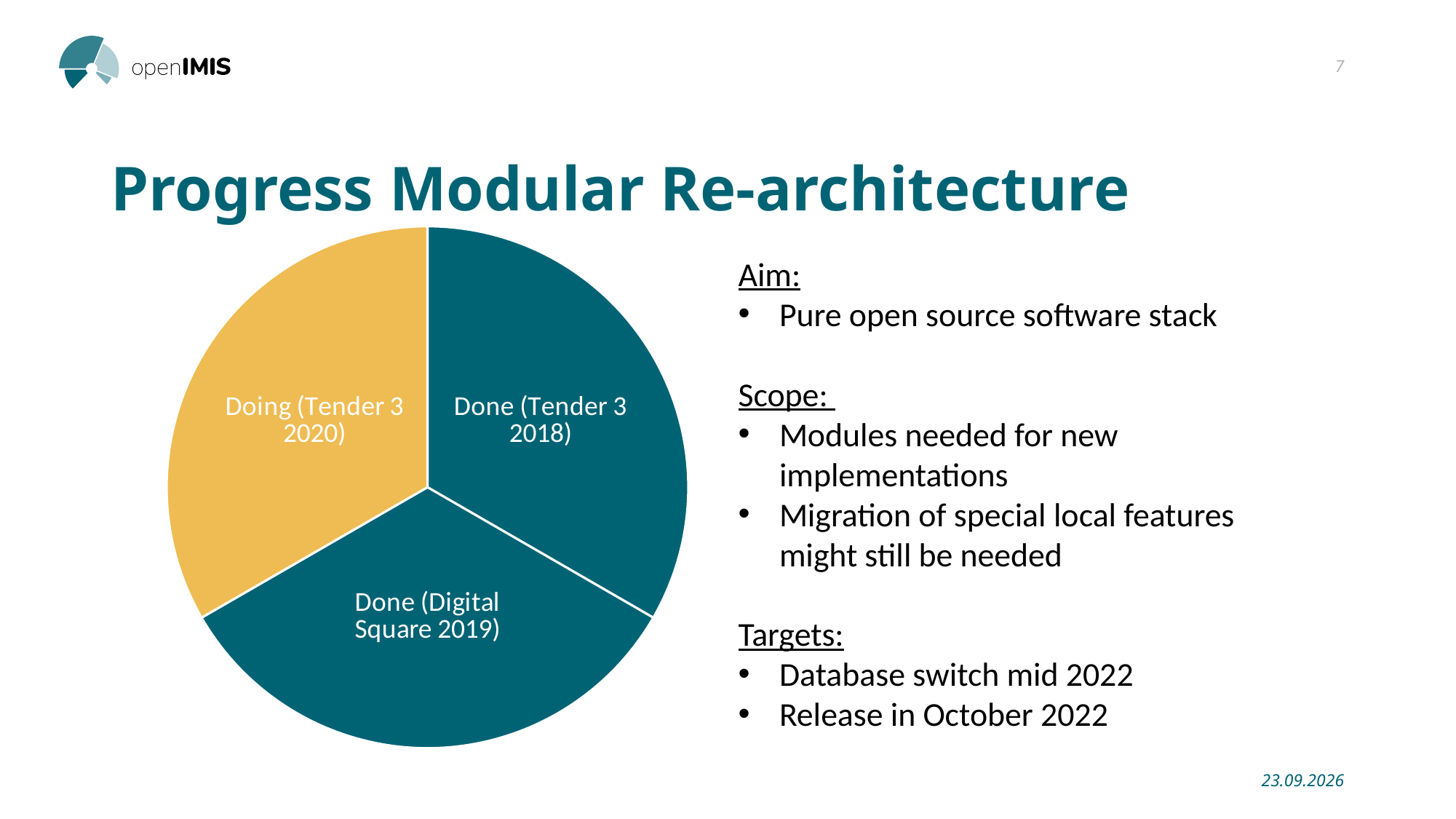
What kind of chart is shown on the slide? pie chart Which slice of the pie chart is coloured yellow? Doing (Tender 3 2020) Which year is associated with the "Done (Tender 3 ...)" slice of the pie chart? 2018 Which year is associated with the Digital Square slice of the pie chart? 2019 How many slices of the pie chart are labelled as "Done"? 2 Does the pie chart show any numeric values or percentages on its slices? No How many slices does the pie chart have? 3 Which slice of the pie chart is labelled as "Doing"? Doing (Tender 3 2020) What colour are the two "Done" slices of the pie chart? dark teal